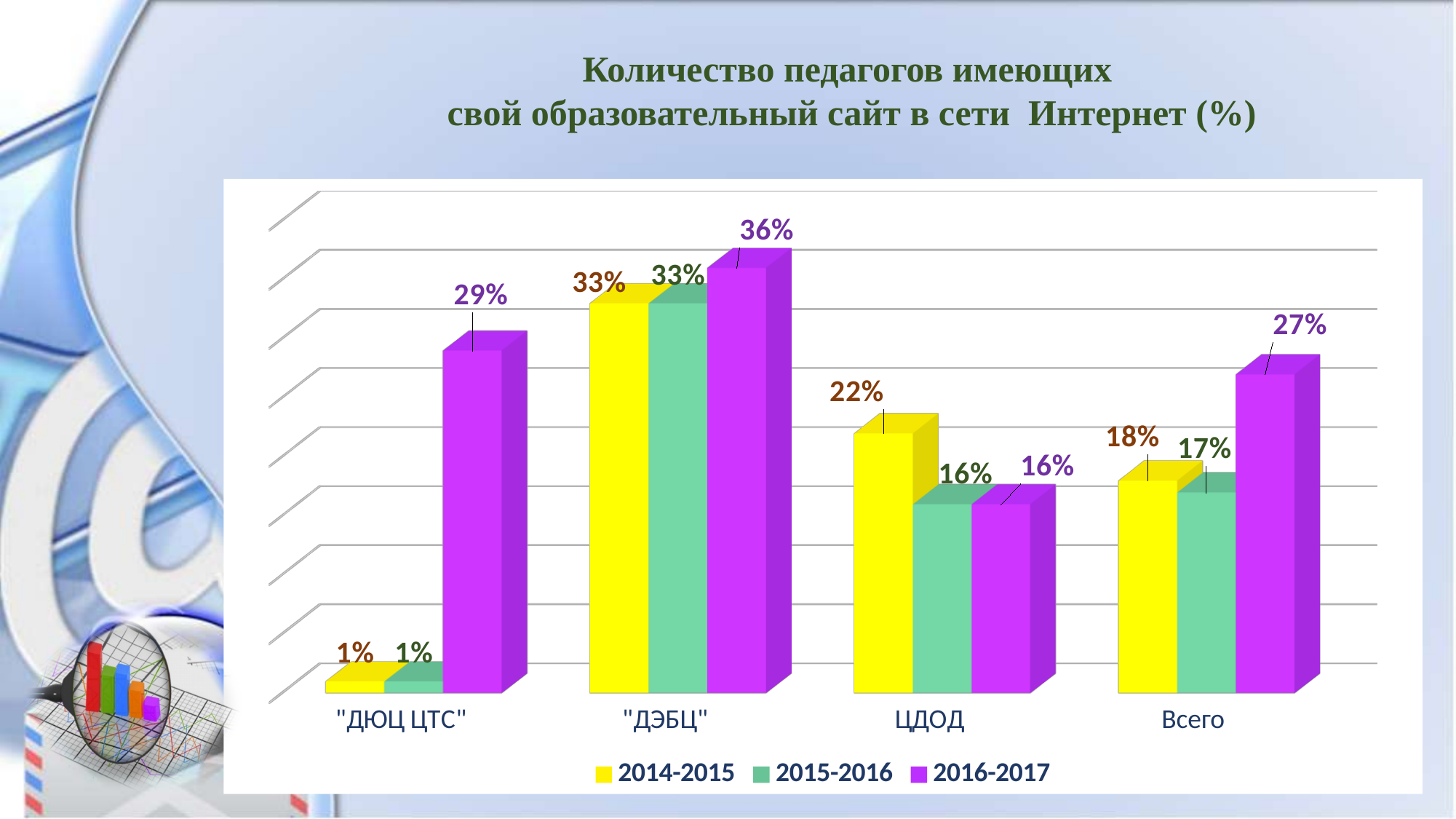
Which category has the highest value in the 2016-2017 series? "ДЭБЦ" What is the difference between the 2016-2017 and 2014-2015 values for Всего? 9% What kind of chart is shown on the slide? Bar chart Which colour represents the 2016-2017 series in the legend? Purple Which category has the lowest value in the 2014-2015 series? "ДЮЦ ЦТС" What is the value for ЦДОД in the 2014-2015 series? 22% What is the value for "ДЮЦ ЦТС" in the 2016-2017 series? 29% How many categories are shown on the x axis? 4 Which is larger for ЦДОД: the 2014-2015 value or the 2015-2016 value? 2014-2015 What is the value for Всего in the 2015-2016 series? 17% What is the value for "ДЭБЦ" in the 2016-2017 series? 36% How many series does the legend list? 3